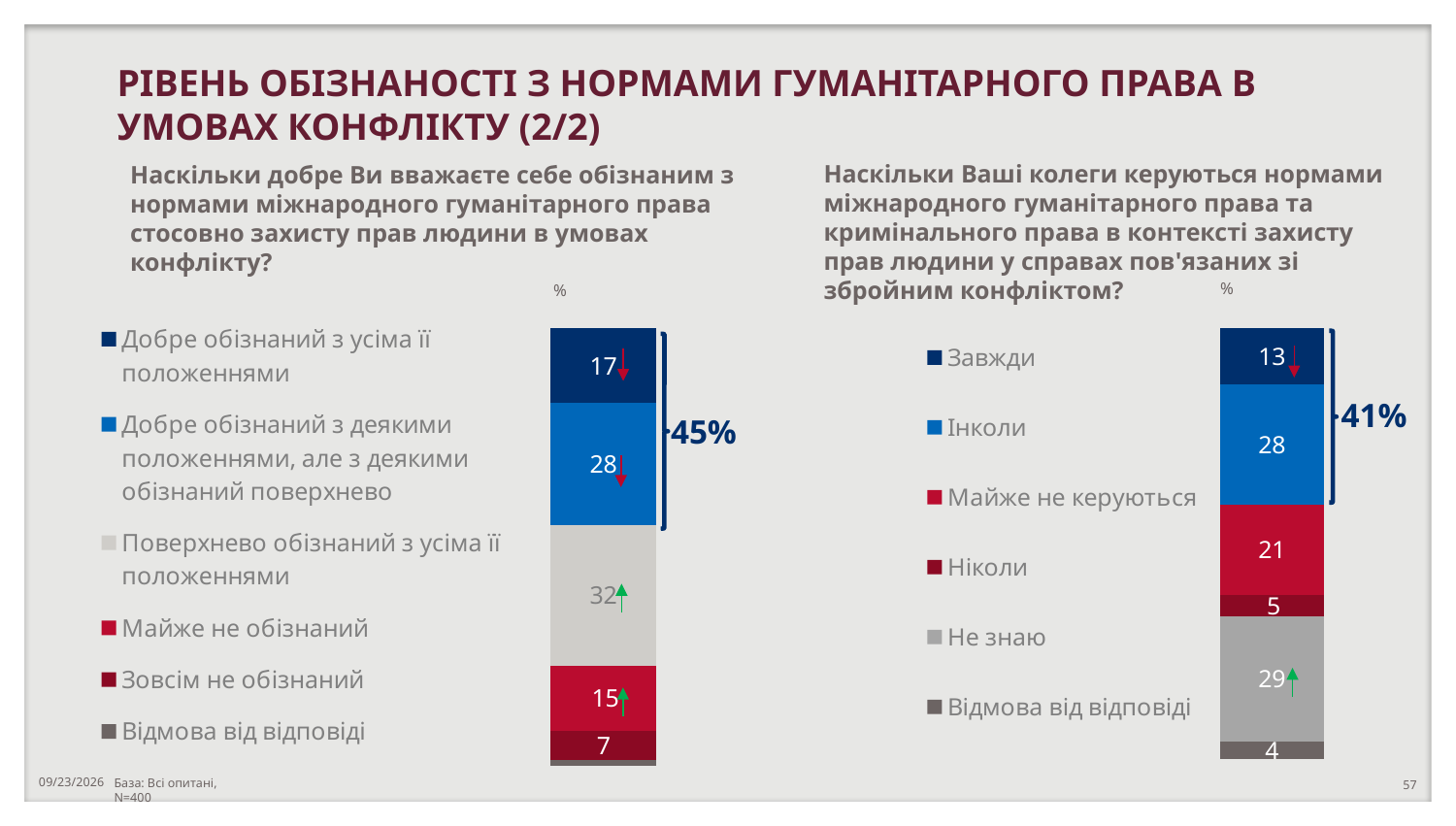
In the right chart, which is larger: the value for 'Інколи' or the value for 'Майже не керуються'? Інколи In the right chart, what is the value for 'Не знаю'? 29 In the right chart, which category has the lowest value? Відмова від відповіді In the right chart, what combined percentage is shown by the bracket next to 'Завжди' and 'Інколи'? 41% In the left chart, which labelled category has the highest value? Поверхнево обізнаний з усіма її положеннями In the left chart, what combined percentage is shown by the bracket next to the top two segments? 45% In the left chart, what is the value for 'Поверхнево обізнаний з усіма її положеннями'? 32 In the right chart, what is the value for 'Ніколи'? 5 How many entries does the legend of the right chart list? 6 In the left chart, what is the value for 'Добре обізнаний з усіма її положеннями'? 17 In the right chart, which category has the highest value? Не знаю In the left chart, what is the difference between the values for 'Добре обізнаний з деякими положеннями, але з деякими обізнаний поверхнево' and 'Майже не обізнаний'? 13